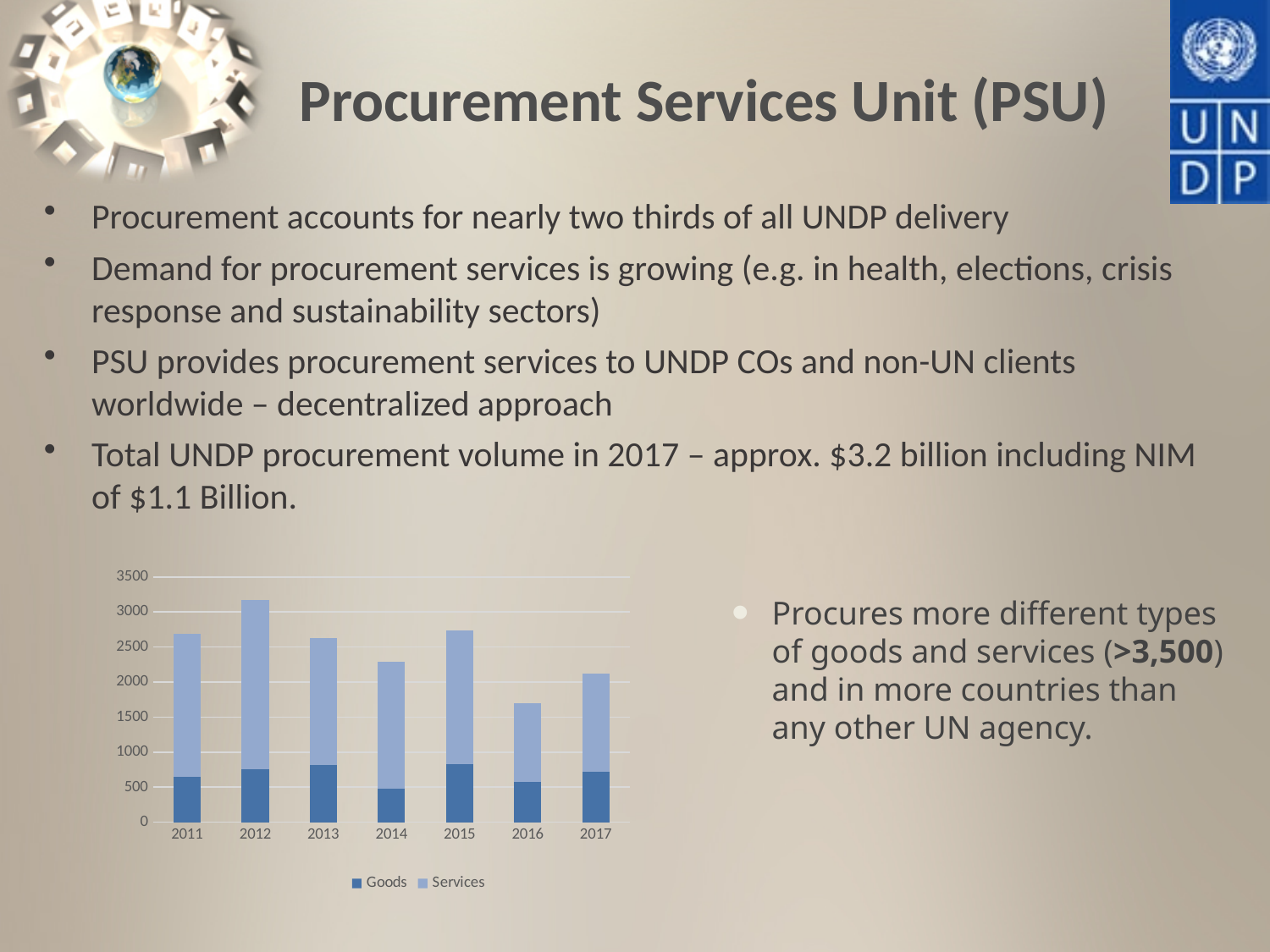
What are the two series named in the chart's legend? Goods and Services Does the total bar rise or fall from 2015 to 2016? fall Which year has the lowest total bar in the chart? 2016 Is the total bar for 2016 greater or less than 2000? less Which year has the larger total bar, 2014 or 2015? 2015 How many series does the chart's legend list? 2 Is the total bar for 2017 greater or less than 2000? greater How many years are shown on the x axis of the chart? 7 What kind of chart is shown on the slide? stacked bar chart Is the total bar for 2012 greater or less than 3000? greater Which year has the highest total bar in the chart? 2012